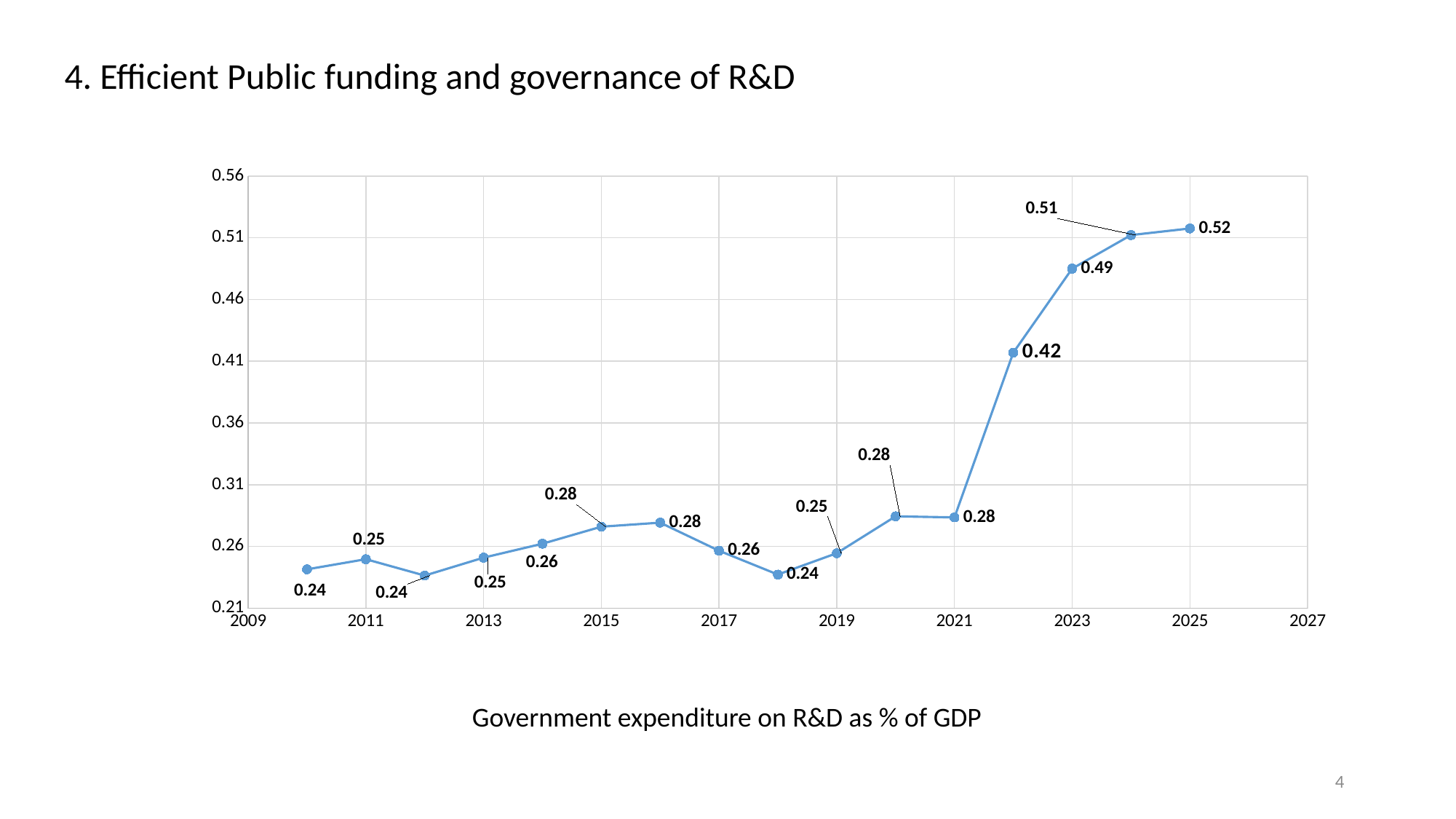
Which year has the highest value on the chart? 2025 Which is larger, the value for 2023 or the value for 2020? 2023 What is the lowest value shown on the chart? 0.24 What is the value plotted for 2022? 0.42 What does the caption below the chart say the data represents? Government expenditure on R&D as % of GDP What is the value plotted for 2015? 0.28 What is the difference between the values for 2023 and 2022? 0.07 What is the difference between the values for 2025 and 2021? 0.24 How many data points are plotted on the chart? 16 What is the value plotted for 2018? 0.24 What kind of chart is shown on the slide? line chart What is the value plotted for 2025? 0.52